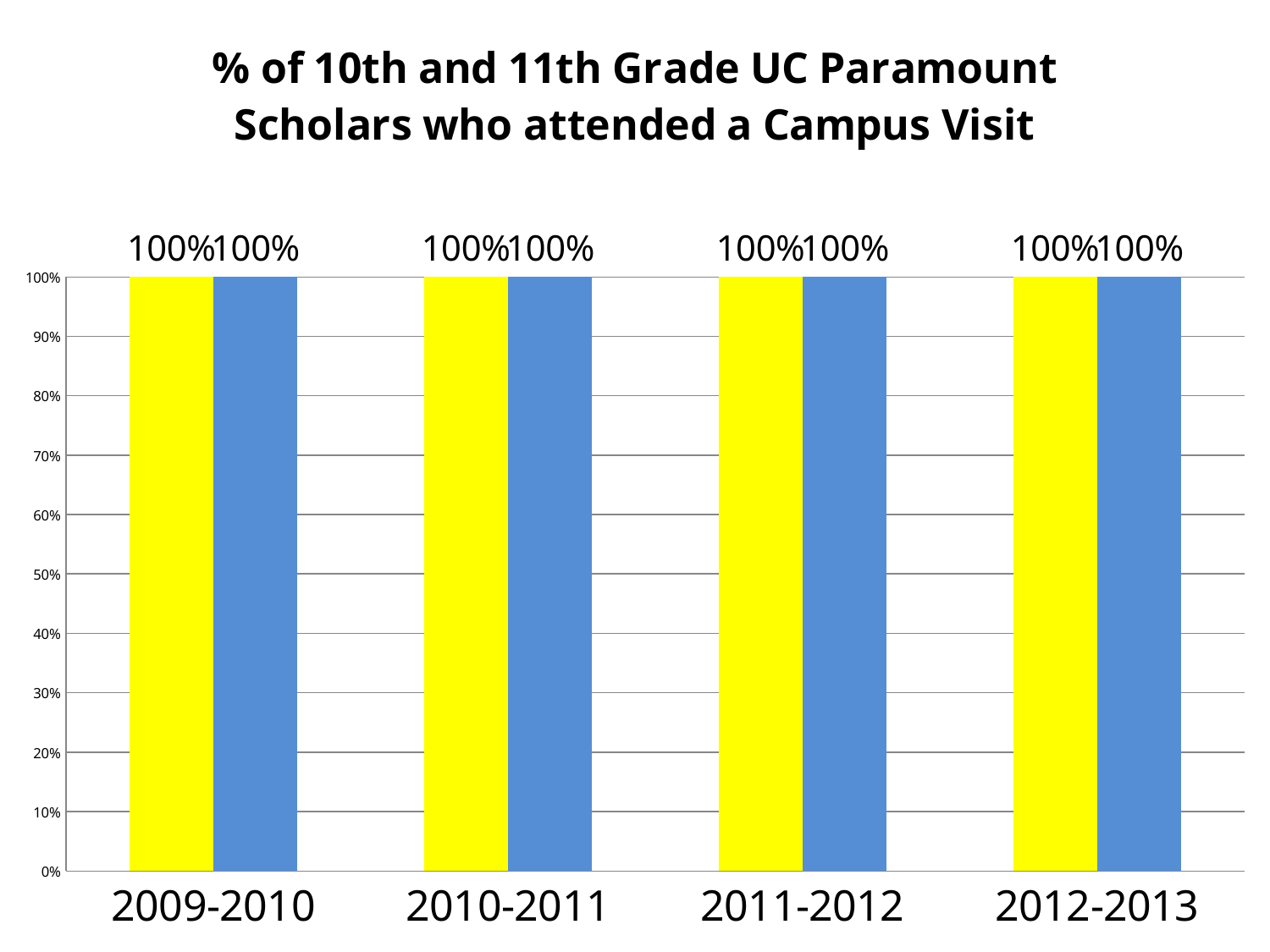
How many bars are plotted for each school year? 2 What type of chart is shown on the slide? bar chart Is the value of the blue bar for 2011-2012 greater or less than 50%? greater What is the title of the chart? % of 10th and 11th Grade UC Paramount Scholars who attended a Campus Visit How many school-year categories are shown on the x axis? 4 What colours are the two bars shown for each school year? yellow and blue Do the values of the yellow bars rise, fall, or stay the same from 2009-2010 to 2012-2013? stay the same What is the difference between the yellow bar and the blue bar for 2012-2013? 0% What is the value of the yellow bar for 2011-2012? 100% What is the value of the blue bar for 2010-2011? 100% What is the value of the blue bar for 2012-2013? 100% What is the value of the yellow bar for 2009-2010? 100%